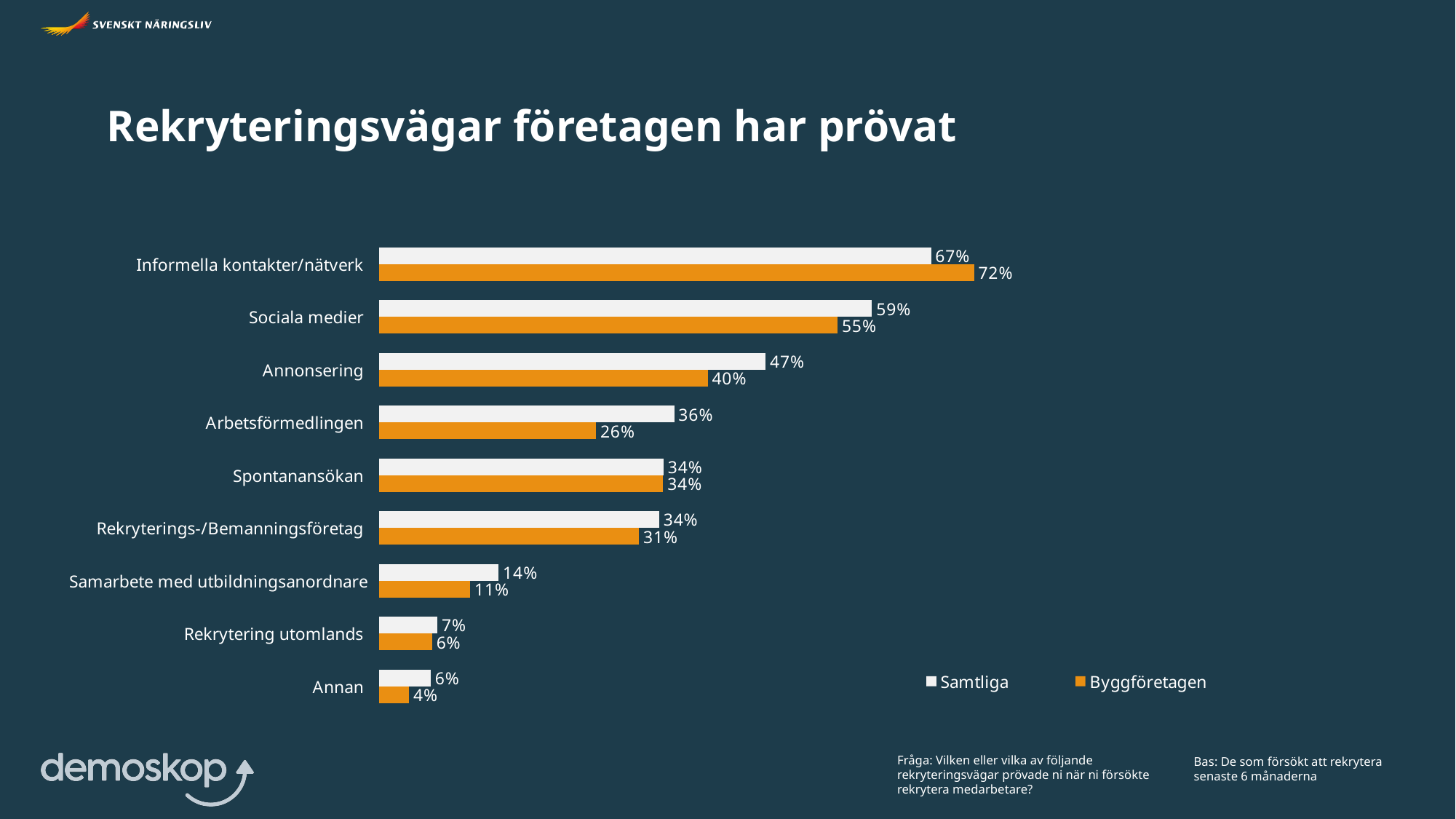
What kind of chart is shown on the slide? Bar chart What is the value for Samtliga for Informella kontakter/nätverk? 67% Which is larger for Arbetsförmedlingen, Samtliga or Byggföretagen? Samtliga What is the value for Byggföretagen for Arbetsförmedlingen? 26% What is the difference between Samtliga and Byggföretagen for Annonsering? 7% How many series does the legend list? 2 What is the value for Byggföretagen for Sociala medier? 55% Which category has the highest value for Byggföretagen? Informella kontakter/nätverk Which category has the lowest value for Samtliga? Annan What is the title of the chart? Rekryteringsvägar företagen har prövat Which series is shown in orange? Byggföretagen How many categories are shown in the chart? 9